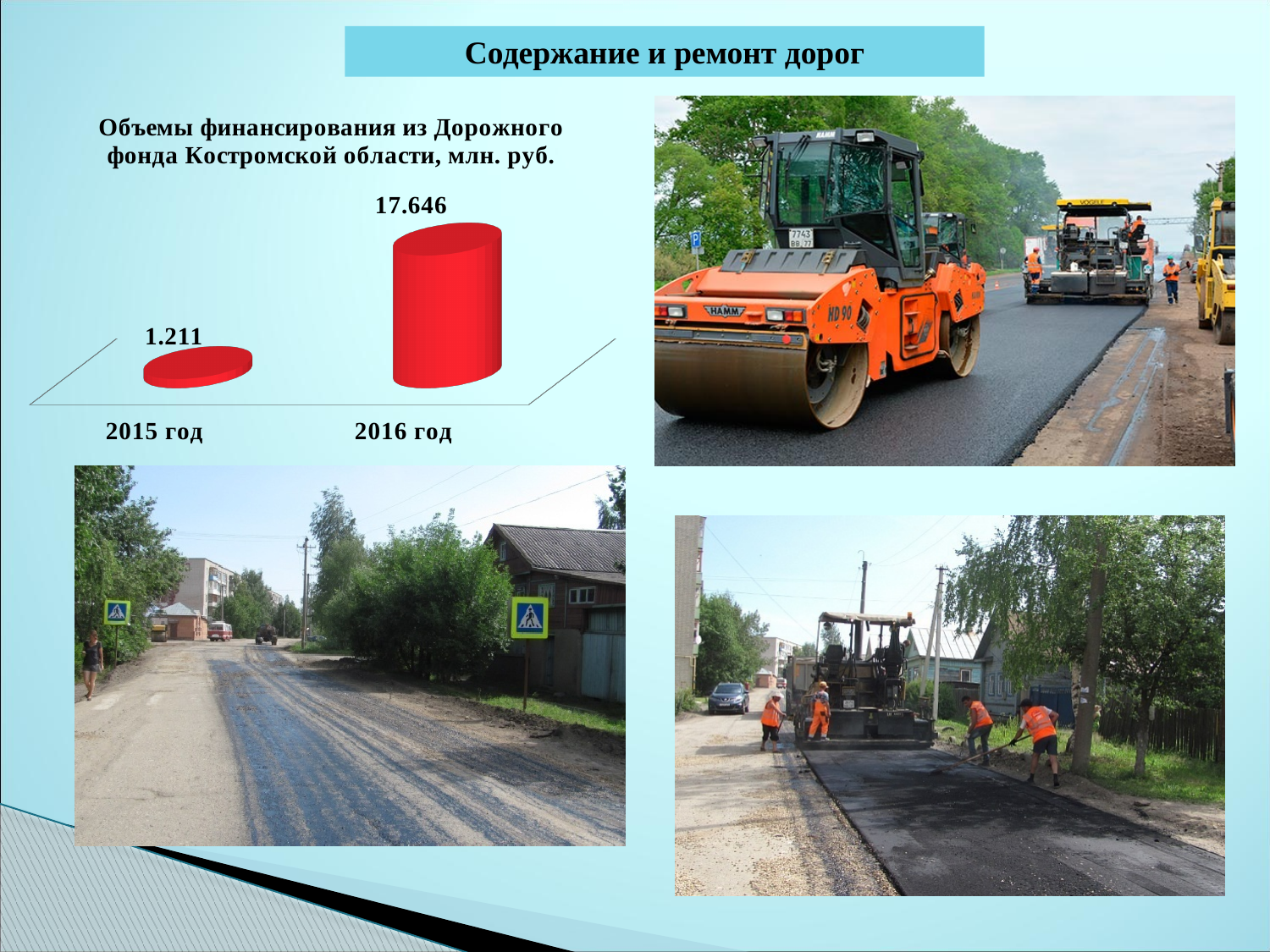
Which year has the lowest value? 2015 год What is the difference between the values for 2016 год and 2015 год? 16.435 Do the values rise or fall from 2015 год to 2016 год? rise What is the value for 2015 год? 1.211 What colour are the bars in the chart? red What is the value for 2016 год? 17.646 Which is larger, the value for 2015 год or the value for 2016 год? 2016 год What kind of chart is shown on the slide? bar chart Which year has the highest value? 2016 год How many categories are shown in the chart? 2 What is the title of the chart? Объемы финансирования из Дорожного фонда Костромской области, млн. руб.